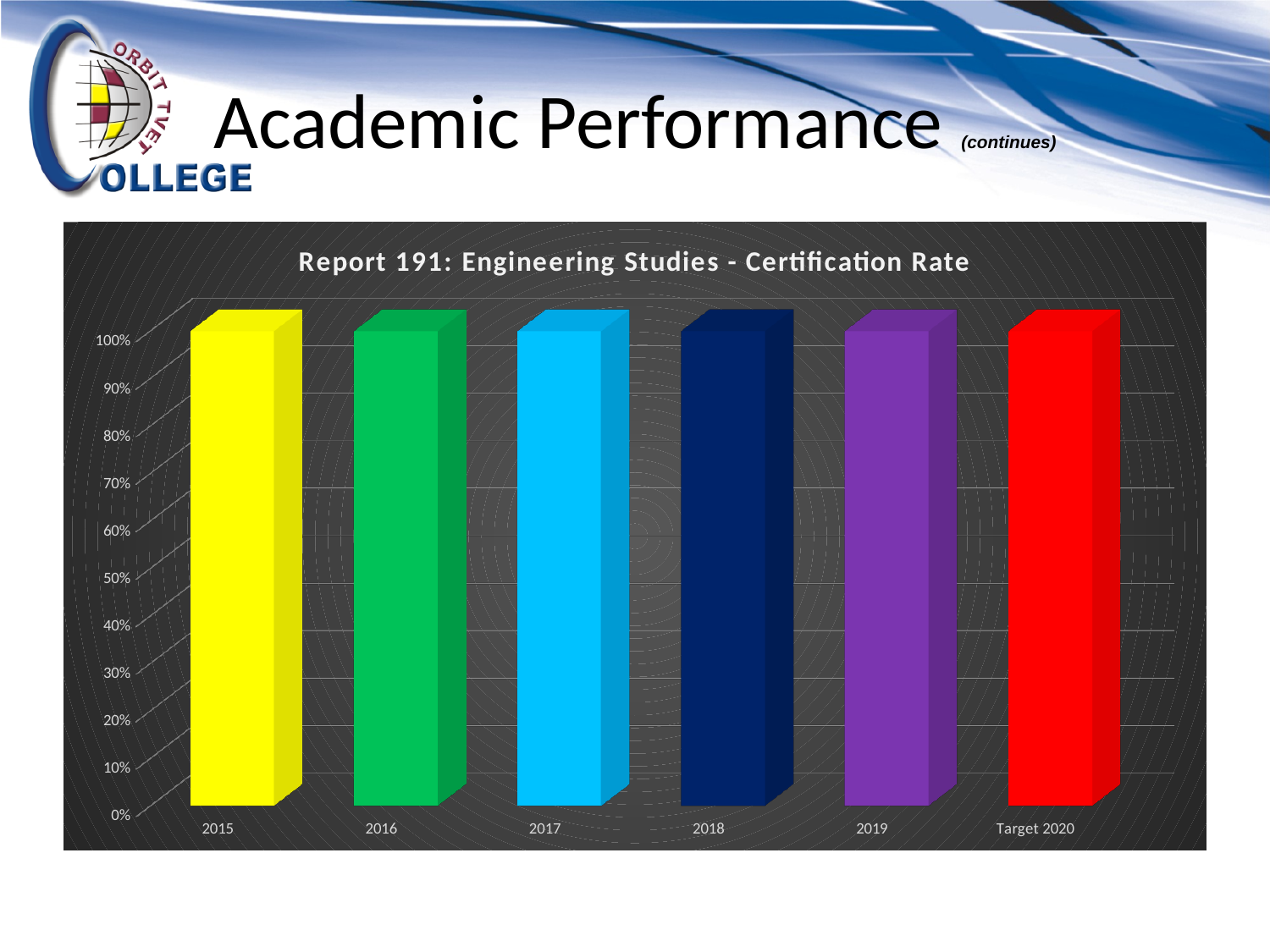
Is the value for Target 2020 greater or less than 90%? greater What kind of chart is shown on the slide? bar chart What is the first year shown on the x axis of the chart? 2015 Is the value for 2019 greater or less than 50%? greater What is the title of the chart? Report 191: Engineering Studies - Certification Rate What is the label of the last category on the x axis? Target 2020 What is the highest value shown on the y axis of the chart? 100% Is the value for 2015 greater or less than 90%? greater How many categories are shown on the x axis of the chart? 6